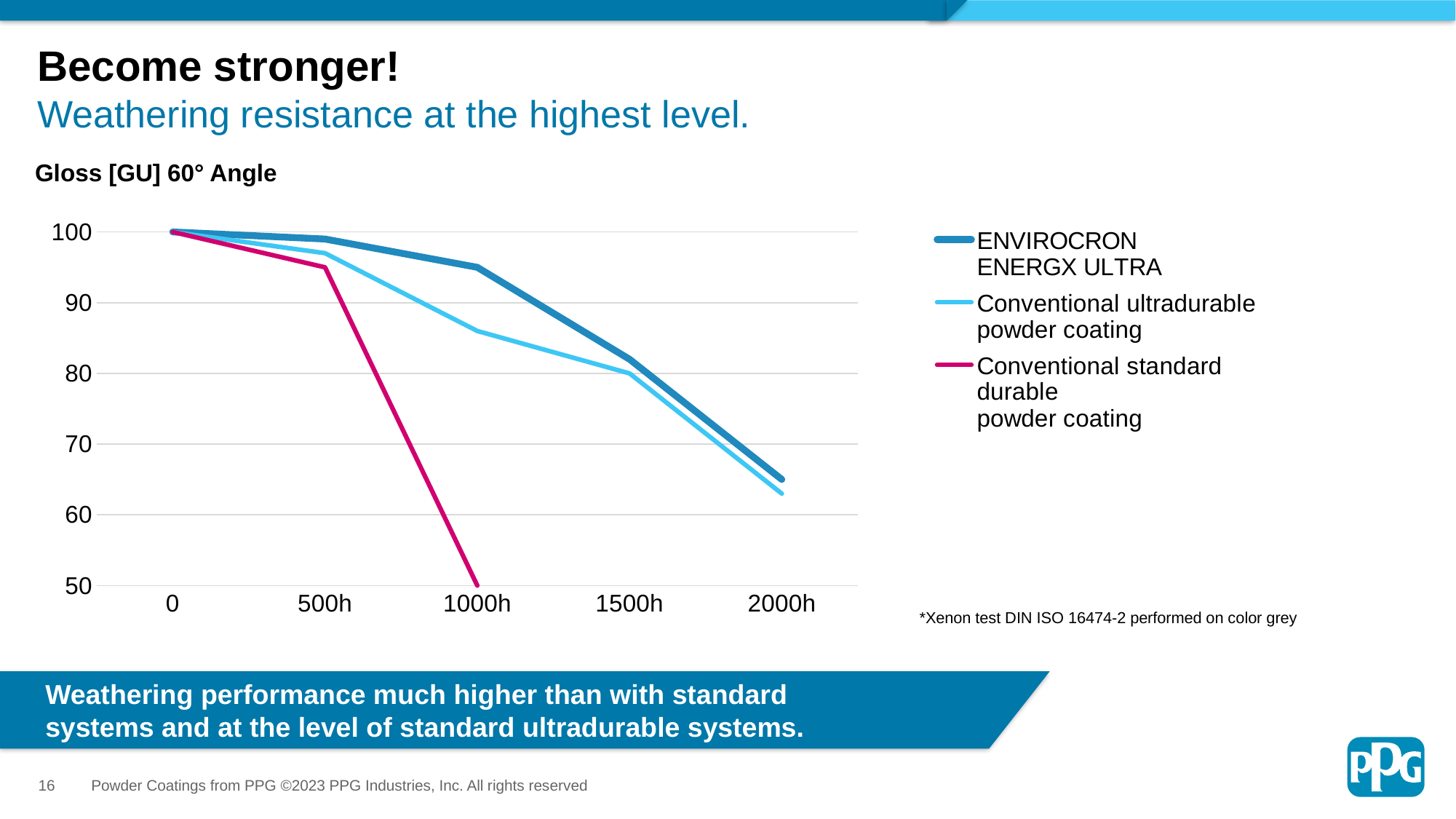
Which series has the lowest value at 1000h? Conventional standard durable powder coating Is the value for ENVIROCRON ENERGX ULTRA at 1000h greater or less than 90? greater At 1000h, which is larger: ENVIROCRON ENERGX ULTRA or the Conventional ultradurable powder coating? ENVIROCRON ENERGX ULTRA What kind of chart is shown on the slide? line chart What is the title shown above the chart's y axis? Gloss [GU] 60° Angle What is the gloss value for the Conventional ultradurable powder coating at 1500h? 80 What is the gloss value for the Conventional standard durable powder coating at 1000h? 50 Do the values for ENVIROCRON ENERGX ULTRA rise or fall along the x axis? fall How many points are labelled on the x axis? 5 How many series does the legend list? 3 What is the gloss value for ENVIROCRON ENERGX ULTRA at 0 hours? 100 Is the value for the Conventional ultradurable powder coating at 2000h greater or less than 70? less